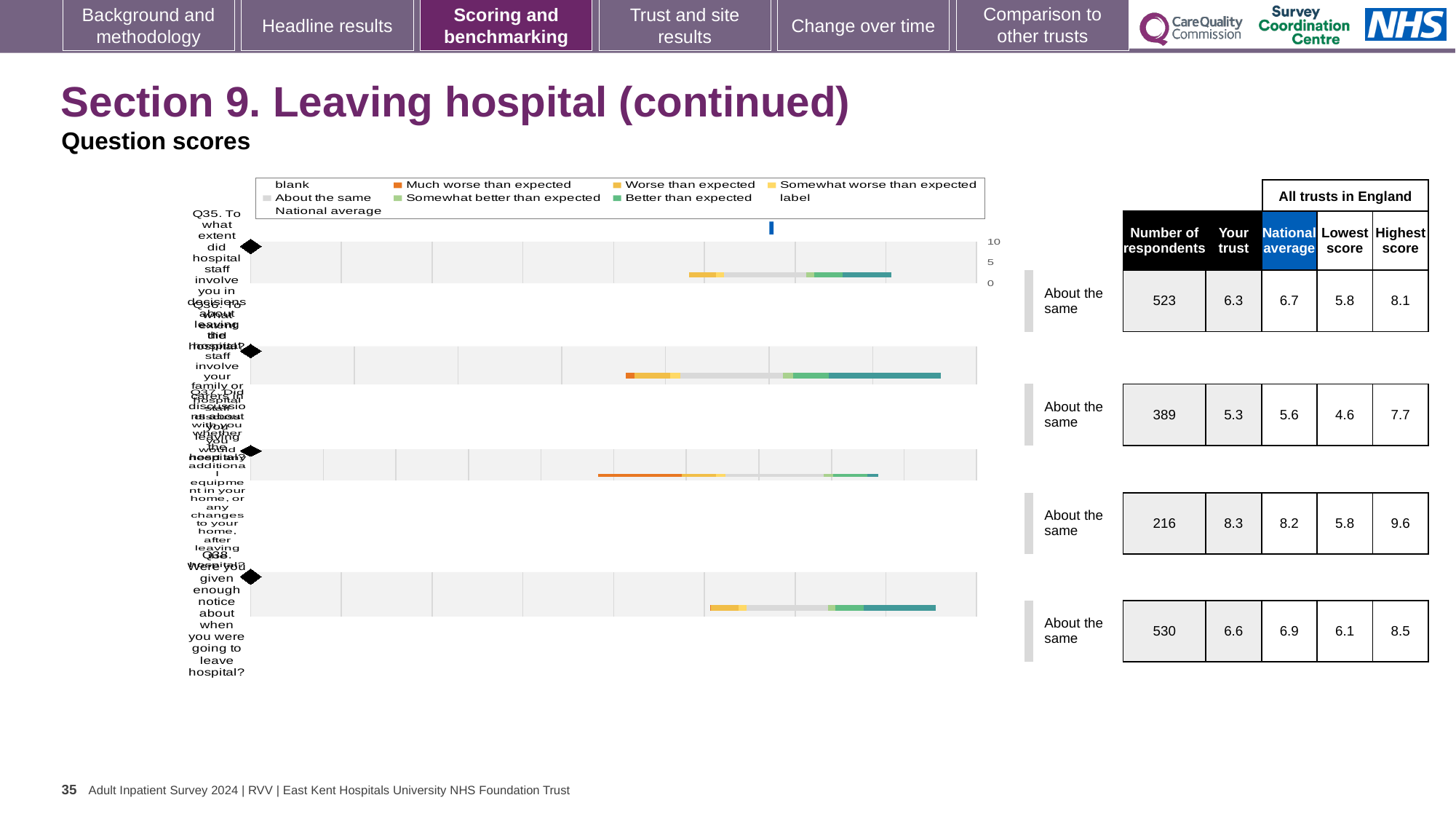
What is the highest score across all trusts in England for Q37? 9.6 What kind of chart is used to show the question scores on this slide? Bar chart What is the national average score for Q37 (discussing additional equipment or changes to your home)? 8.2 What benchmark category is shown next to each of the four questions in the chart? About the same For Q37, which is larger: the 'Your trust' score or the national average? Your trust Which question has the lowest 'Your trust' score? Q36 What is the 'Your trust' score for Q35 (involving you in decisions about leaving hospital)? 6.3 How many questions (rows) are plotted in the chart? 4 What is the lowest score across all trusts in England for Q36? 4.6 For Q38 (enough notice about leaving hospital), what is the difference between the national average and the 'Your trust' score? 0.3 Which question has the highest 'Your trust' score? Q37 How many respondents answered Q36 (involving family or carers in decisions about leaving hospital)? 389